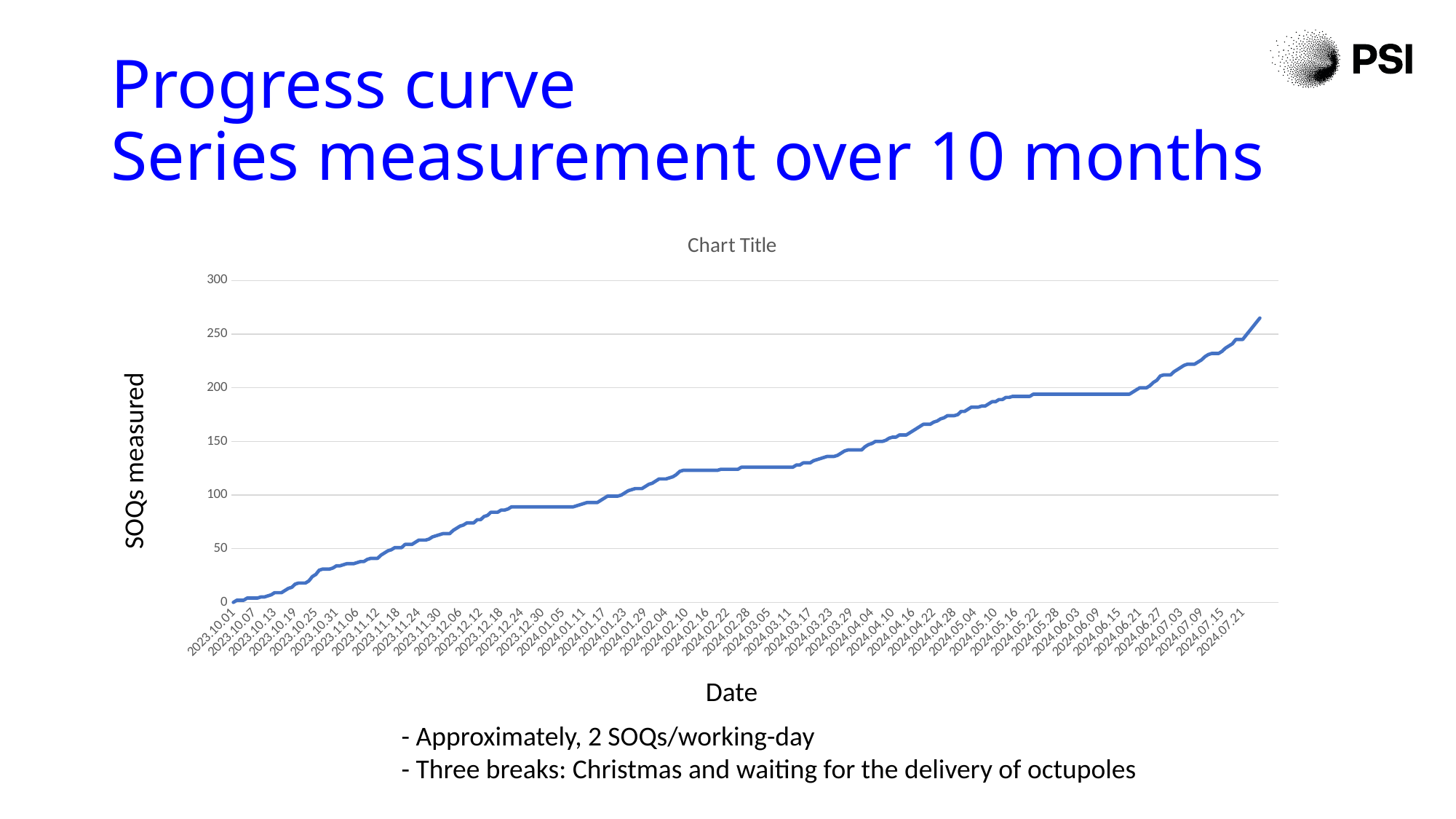
Is the value for 2023.10.25 greater or less than 50? less Is the value for 2024.02.10 greater or less than 150? less Is the value for 2023.12.24 greater or less than 100? less Do the SOQs measured rise or fall along the x axis from 2023.10.01 to 2024.07.21? rise What is the label of the vertical axis? SOQs measured What is the label of the horizontal axis? Date What kind of chart is shown on the slide? line chart